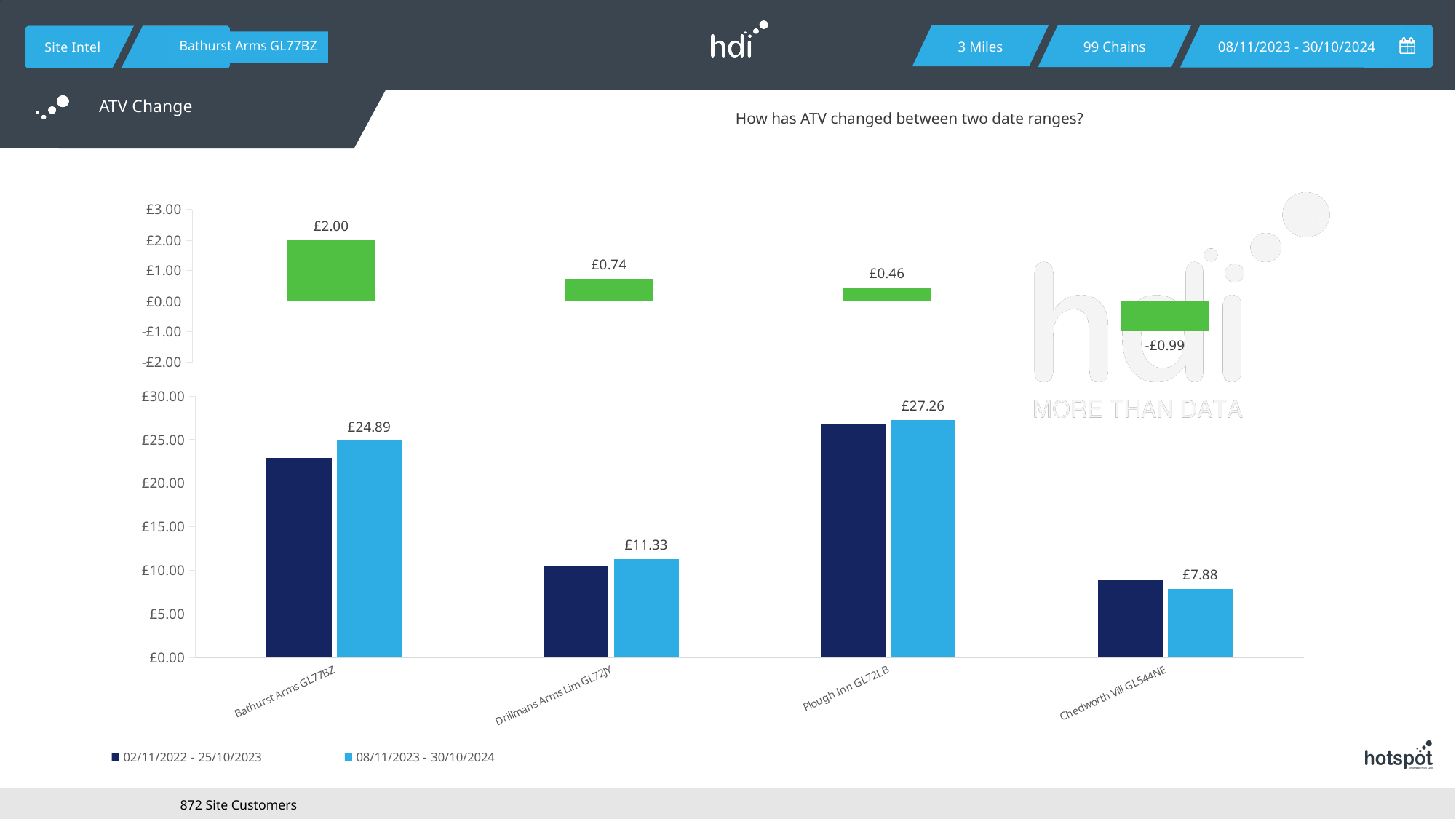
In the top chart, which site has the lowest ATV change? Chedworth Vill GL544NE How many sites are shown on the x axis of the bottom chart? 4 In the bottom chart, is the value for Bathurst Arms GL77BZ in the 02/11/2022 - 25/10/2023 period greater or less than £20.00? greater In the top chart, which site has the highest ATV change? Bathurst Arms GL77BZ In the bottom chart, is the value for Chedworth Vill GL544NE in the 02/11/2022 - 25/10/2023 period greater or less than £10.00? less In the top chart, what is the ATV change for Bathurst Arms GL77BZ? £2.00 In the bottom chart, what is the difference between Plough Inn GL72LB and Bathurst Arms GL77BZ for the 08/11/2023 - 30/10/2024 period? £2.37 How many series does the legend of the bottom chart list? 2 In the top chart, what is the ATV change for Chedworth Vill GL544NE? -£0.99 In the bottom chart, what is the value for Drillmans Arms Lim GL72JY in the 08/11/2023 - 30/10/2024 period? £11.33 In the bottom chart, what is the value for Plough Inn GL72LB in the 08/11/2023 - 30/10/2024 period? £27.26 In the bottom chart, which is larger for the 08/11/2023 - 30/10/2024 period: Bathurst Arms GL77BZ or Drillmans Arms Lim GL72JY? Bathurst Arms GL77BZ